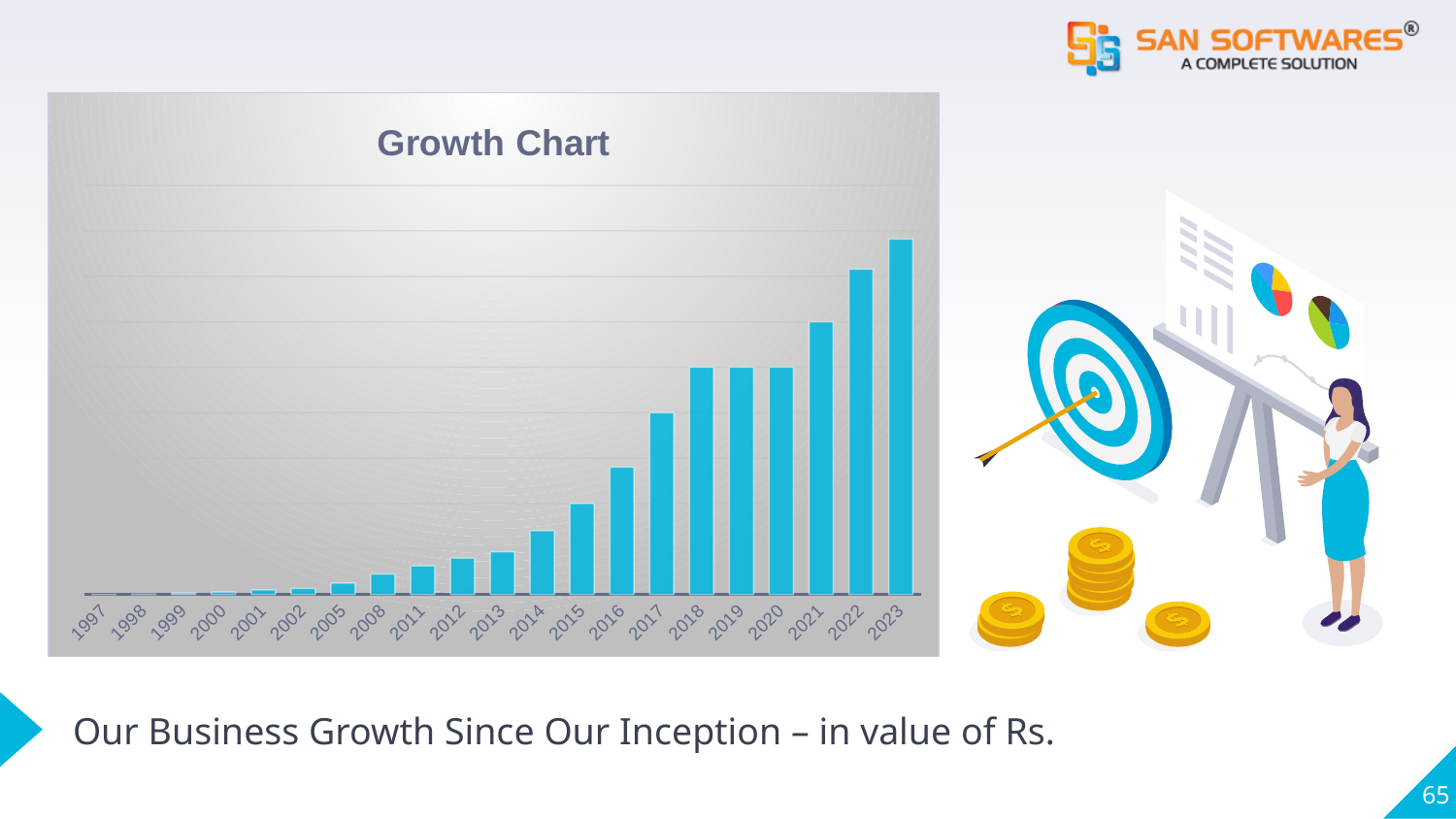
How many years are shown on the x axis of the Growth Chart? 21 Do the bars in the Growth Chart generally rise or fall from 1997 to 2023? rise Which year has the taller bar, 2014 or 2021? 2021 Which year has the taller bar, 2022 or 2016? 2022 Which year has the taller bar, 2017 or 2023? 2023 Which year has the highest bar in the Growth Chart? 2023 What kind of chart is shown on the slide? bar chart What is the first year shown on the x axis of the Growth Chart? 1997 What is the title of the chart? Growth Chart